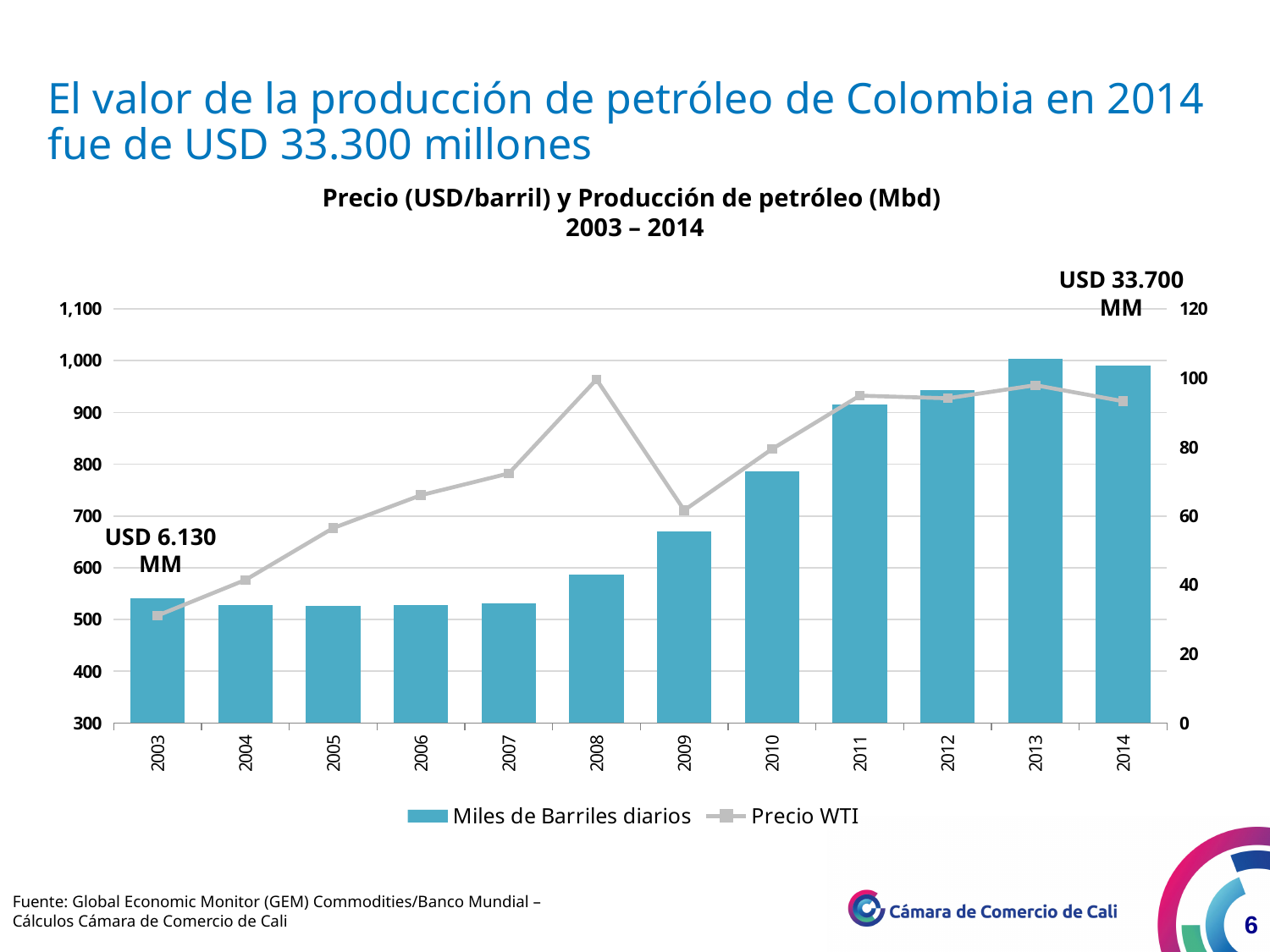
Do the Miles de Barriles diarios bars rise or fall from 2009 to 2013? rise What kind of chart is shown on the slide? A combined bar and line chart In which year is the Precio WTI line at its lowest point? 2003 Is the Miles de Barriles diarios value for 2011 greater or less than 900? greater Which year has the higher Precio WTI value, 2008 or 2009? 2008 Which year has the tallest bar for Miles de Barriles diarios? 2013 How many series does the chart legend list? 2 Is the Miles de Barriles diarios value for 2009 greater or less than 700? less How many years are shown on the x axis of the chart? 12 Which year has the larger Miles de Barriles diarios bar, 2009 or 2010? 2010 Is the Precio WTI value for 2008 greater or less than 80? greater What is the title of the chart? Precio (USD/barril) y Producción de petróleo (Mbd) 2003 – 2014